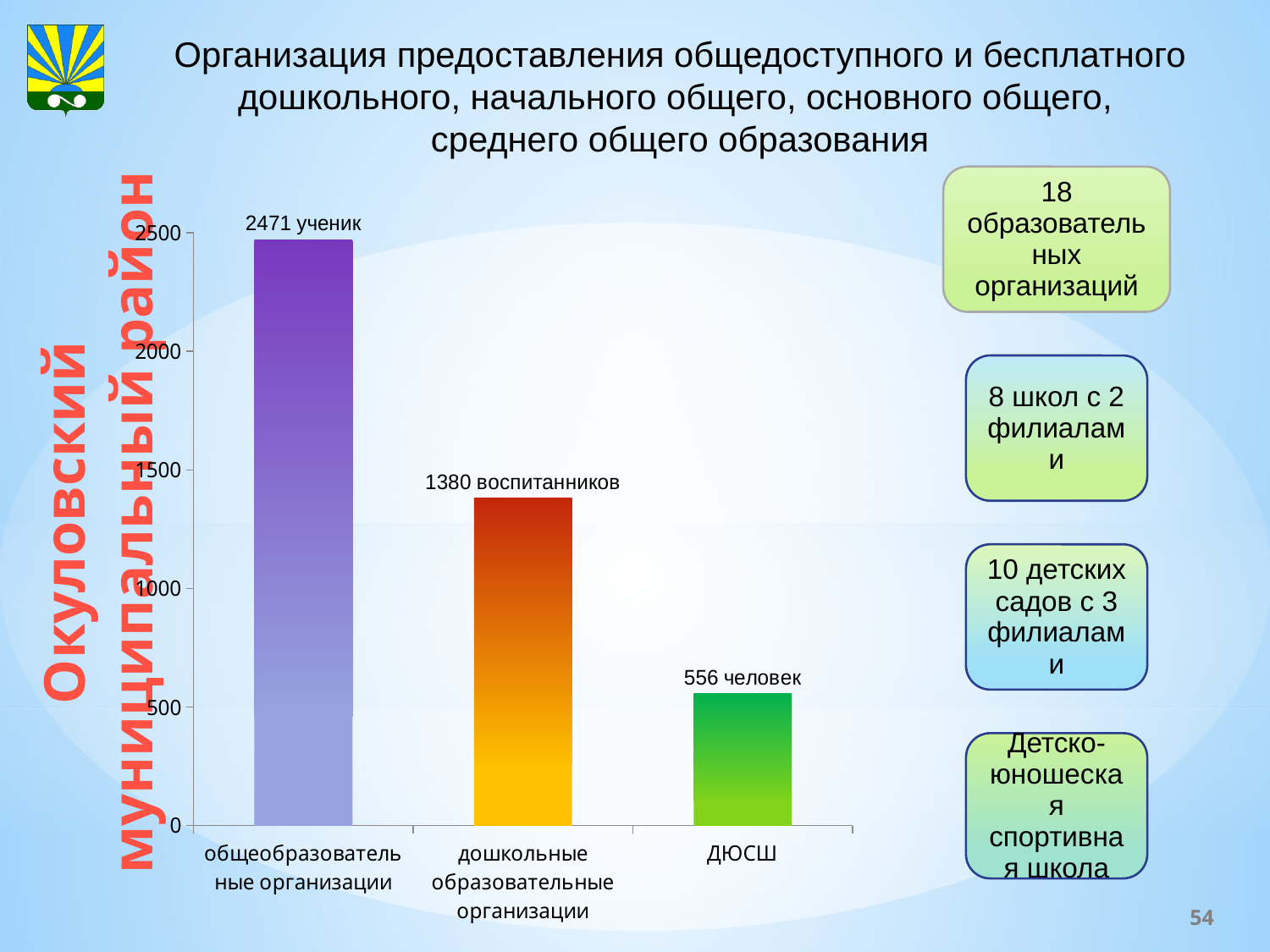
Which category has the lowest value? ДЮСШ What is the difference between the values for дошкольные образовательные организации and ДЮСШ? 824 What value is shown for общеобразовательные организации? 2471 ученик Do the bar values rise or fall from left to right along the x axis? fall What value is shown for ДЮСШ? 556 человек Which category has the highest value? общеобразовательные организации What is the difference between the values for общеобразовательные организации and дошкольные образовательные организации? 1091 What kind of chart is shown on the slide? bar chart Which is larger: the value for дошкольные образовательные организации or the value for ДЮСШ? дошкольные образовательные организации How many categories are shown on the chart? 3 What value is shown for дошкольные образовательные организации? 1380 воспитанников Is the value for ДЮСШ greater or less than 1000? less